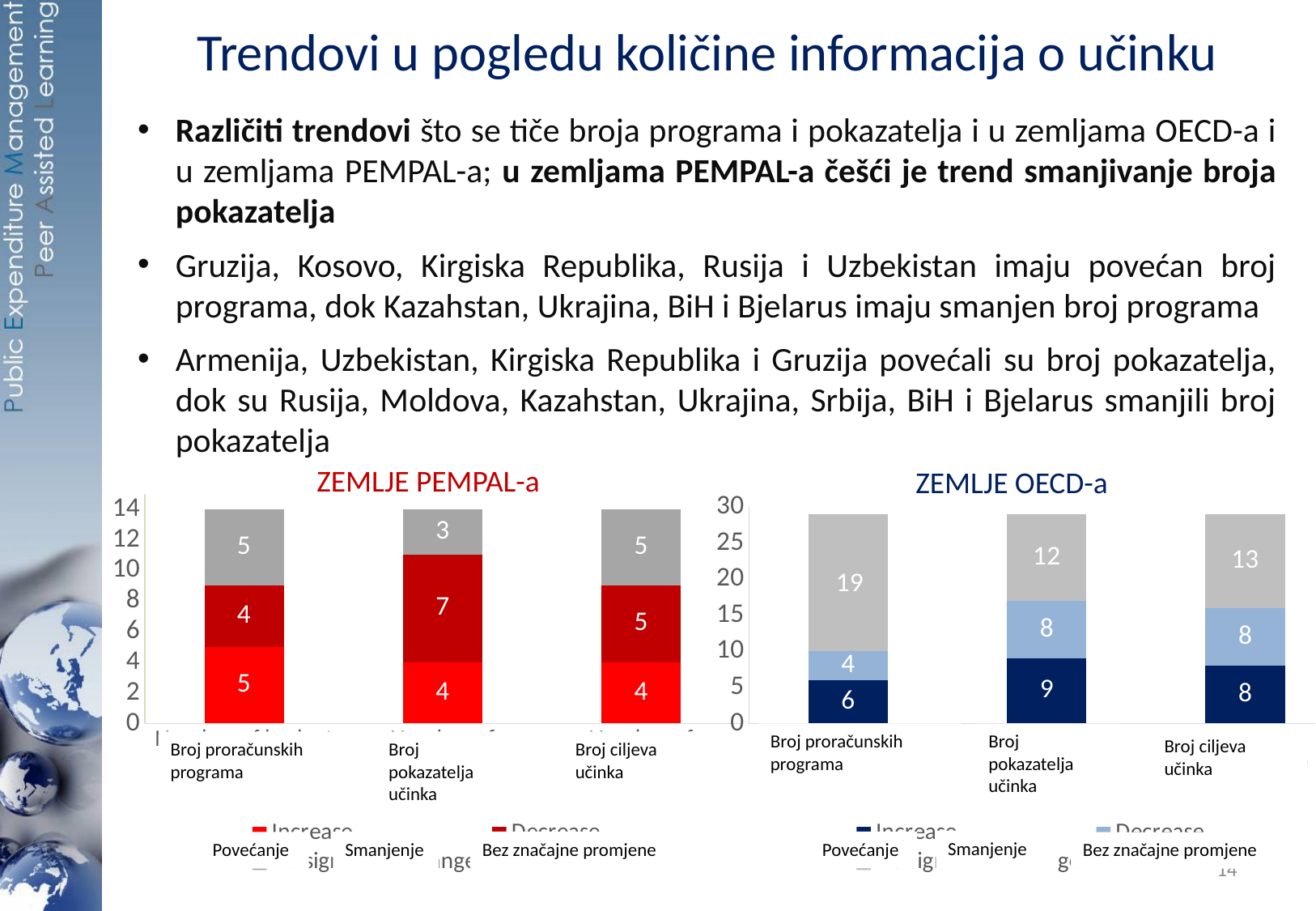
In the ZEMLJE OECD-a chart, what is the value for Bez značajne promjene for Broj proračunskih programa? 19 In the ZEMLJE OECD-a chart, what is the total of the stacked bar for Broj pokazatelja učinka? 29 In the ZEMLJE PEMPAL-a chart, what is the value for Povećanje for Broj proračunskih programa? 5 In the ZEMLJE OECD-a chart, what is the difference between the Bez značajne promjene value for Broj proračunskih programa and for Broj ciljeva učinka? 6 In the ZEMLJE PEMPAL-a chart, what is the total of the stacked bar for Broj ciljeva učinka? 14 In the ZEMLJE PEMPAL-a chart, is the Smanjenje value for Broj pokazatelja učinka larger or smaller than the Smanjenje value for Broj proračunskih programa? larger In the ZEMLJE OECD-a chart, which category has the lowest Povećanje value? Broj proračunskih programa What kind of chart is the ZEMLJE PEMPAL-a chart? stacked bar chart In the ZEMLJE OECD-a chart, what is the value for Povećanje for Broj pokazatelja učinka? 9 How many series does the legend of the ZEMLJE OECD-a chart list? 3 In the ZEMLJE PEMPAL-a chart, which category has the highest Smanjenje value? Broj pokazatelja učinka In the ZEMLJE PEMPAL-a chart, what is the value for Smanjenje for Broj pokazatelja učinka? 7